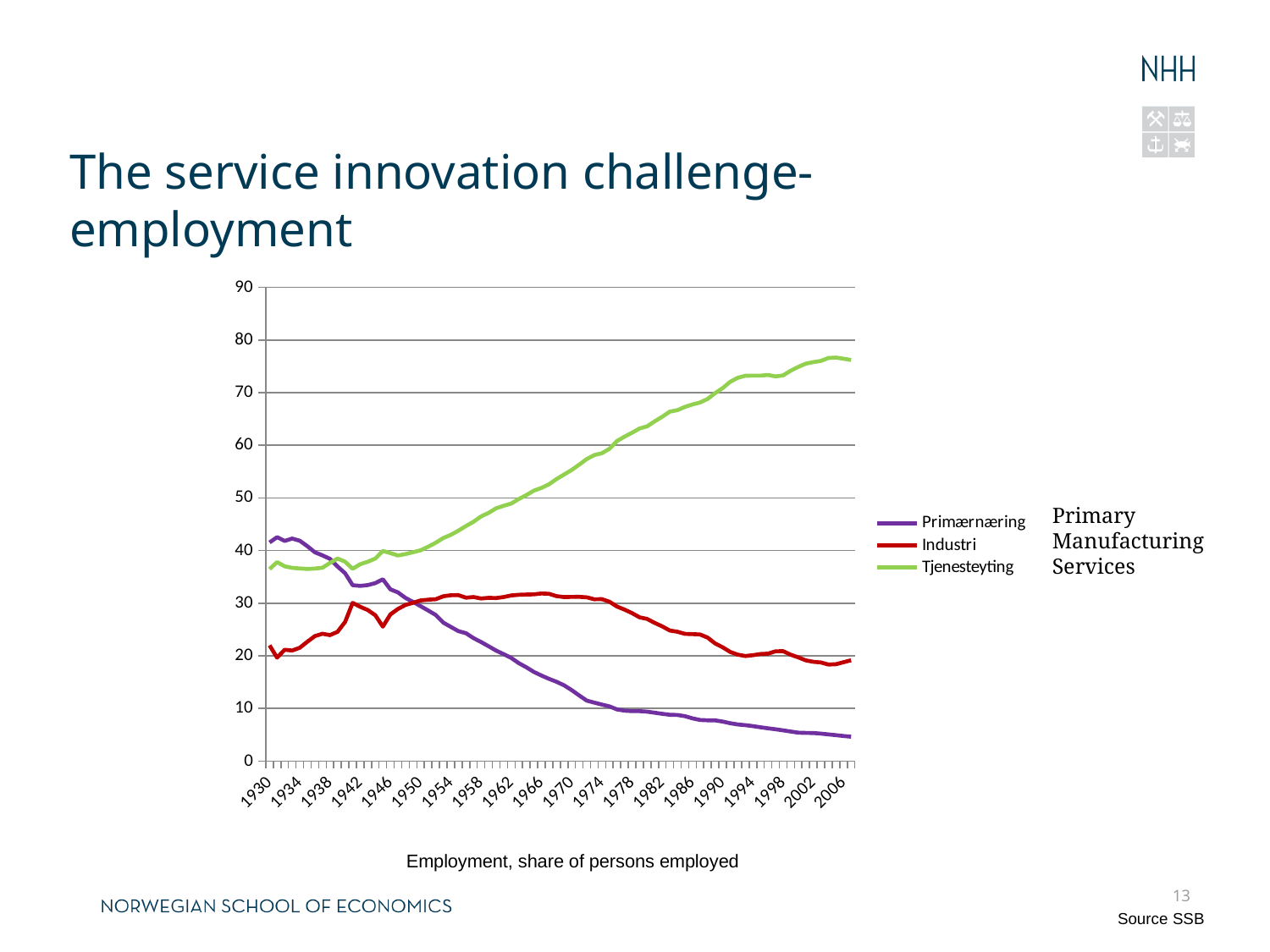
What are the three series named in the chart's legend? Primærnæring, Industri, Tjenesteyting Does the Tjenesteyting series rise or fall from 1930 to 2006? rise Which series has the highest value in 2006? Tjenesteyting Is the value for Primærnæring in 2006 greater or less than 10? less Is the value for Industri in 1990 greater or less than 30? less What kind of chart is shown on the slide? line chart In 1930, which is larger: the value for Primærnæring or the value for Industri? Primærnæring What caption appears below the chart? Employment, share of persons employed How many series does the chart's legend list? 3 Is the value for Tjenesteyting in 2006 greater or less than 70? greater Which series has the lowest value in 2006? Primærnæring Does the Primærnæring series rise or fall from 1930 to 2006? fall